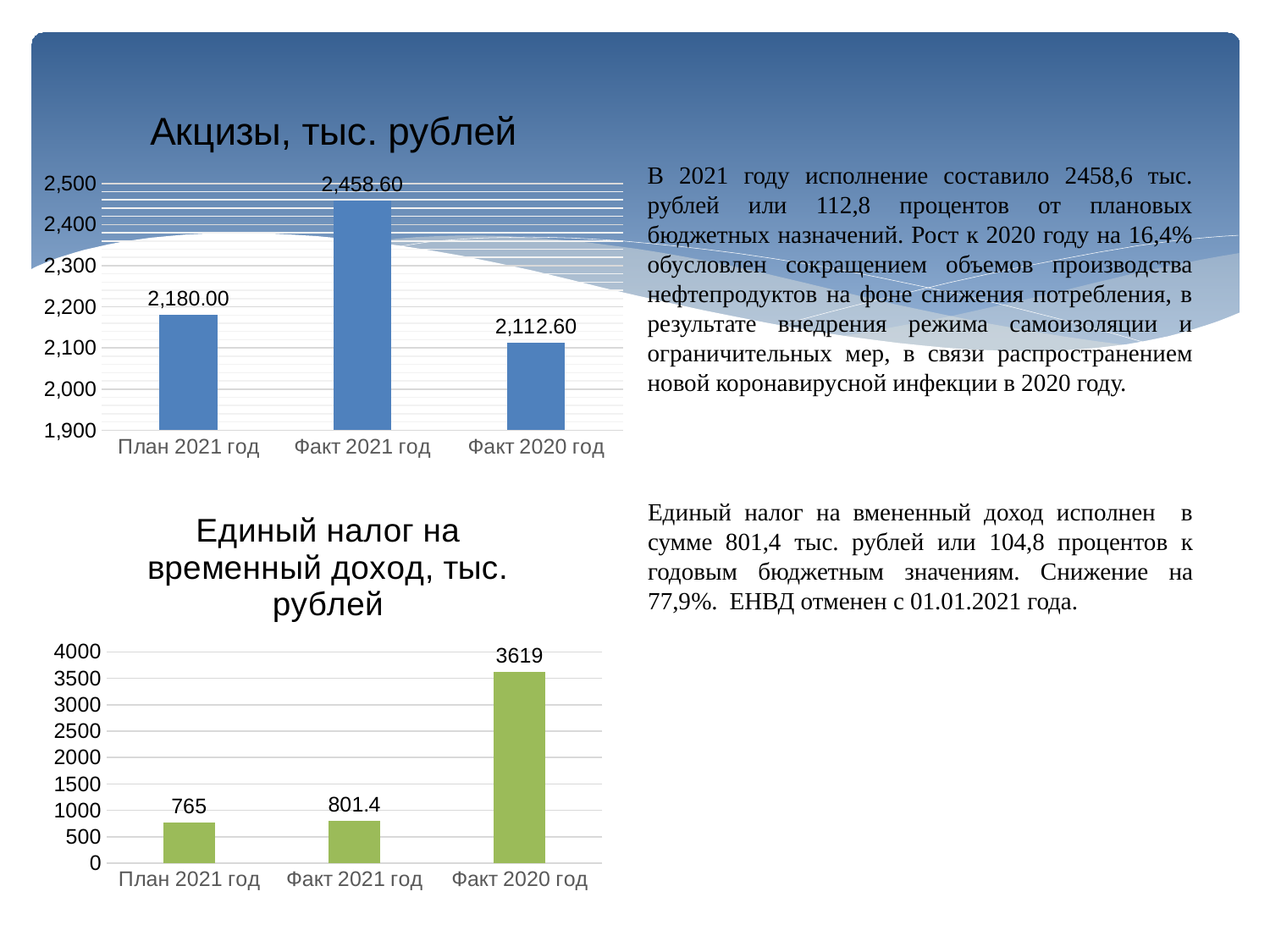
In the chart titled "Акцизы, тыс. рублей", what is the value for "Факт 2021 год"? 2,458.60 In the chart titled "Акцизы, тыс. рублей", which category has the lowest value? Факт 2020 год In the chart titled "Единый налог на временный доход, тыс. рублей", which is larger: "План 2021 год" or "Факт 2021 год"? Факт 2021 год In the chart titled "Акцизы, тыс. рублей", what is the difference between "Факт 2021 год" and "План 2021 год"? 278.60 In the chart titled "Акцизы, тыс. рублей", is the value for "Факт 2020 год" greater or less than 2,200? less In the chart titled "Акцизы, тыс. рублей", how many bars are plotted? 3 In the chart titled "Единый налог на временный доход, тыс. рублей", what is the difference between "Факт 2020 год" and "Факт 2021 год"? 2817.6 In the chart titled "Единый налог на временный доход, тыс. рублей", what is the value for "Факт 2020 год"? 3619 In the chart titled "Единый налог на временный доход, тыс. рублей", which category has the highest value? Факт 2020 год What type of chart is the bottom chart on the slide? bar chart In the chart titled "Единый налог на временный доход, тыс. рублей", what is the value for "Факт 2021 год"? 801.4 In the chart titled "Акцизы, тыс. рублей", what is the value for "План 2021 год"? 2,180.00